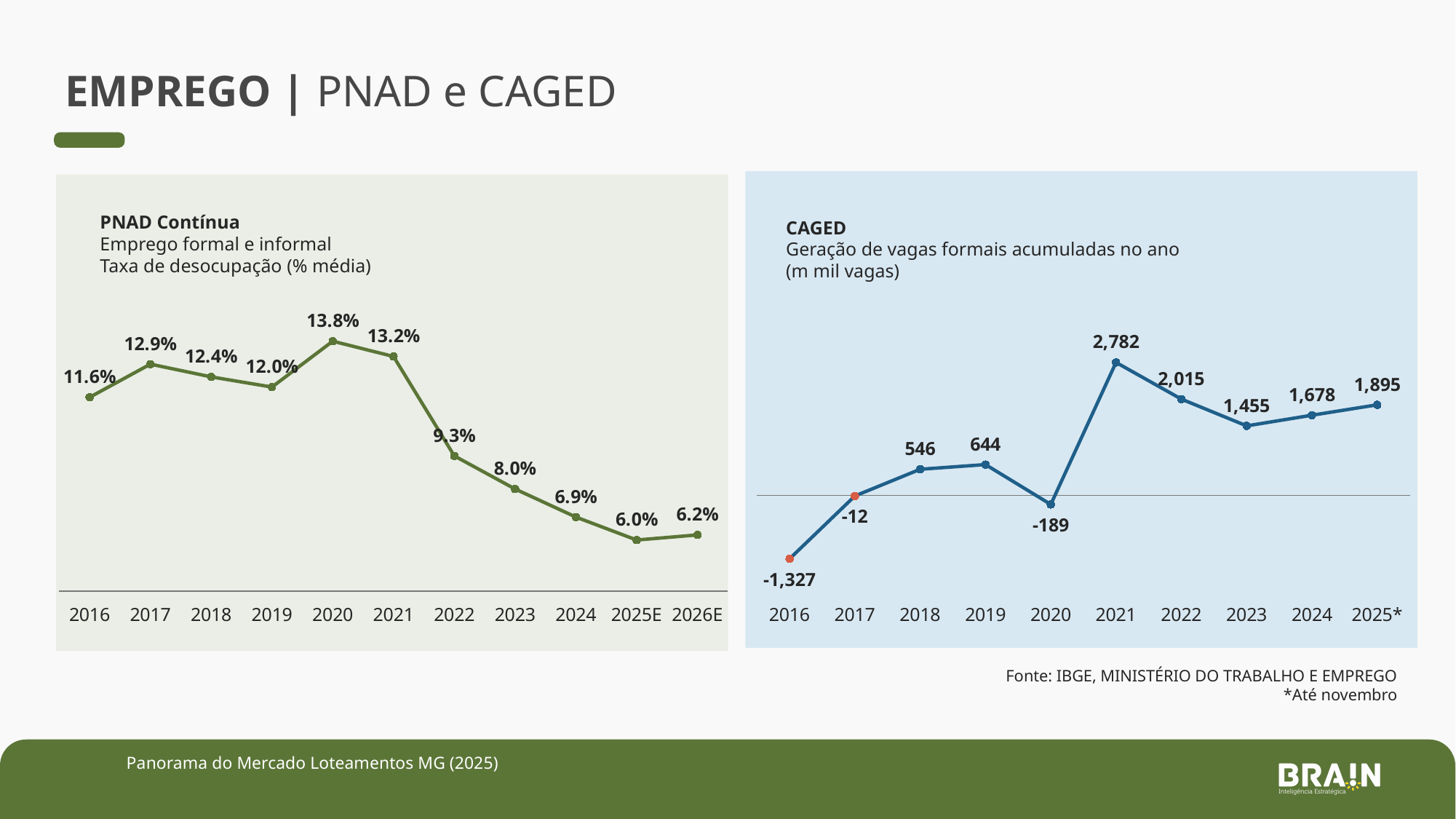
In the CAGED chart, what is the value for 2021? 2,782 What kind of chart is the CAGED chart? line chart In the CAGED chart, which year has the lowest value? 2016 In the PNAD Contínua chart, what is the difference between the 2020 and 2022 values? 4.5 percentage points In the PNAD Contínua chart, what is the unemployment rate for 2020? 13.8% In the CAGED chart, how many years have negative values? 3 In the PNAD Contínua chart, which year has the lowest unemployment rate? 2025E In the PNAD Contínua chart, how many years are plotted on the x axis? 11 In the PNAD Contínua chart, does the unemployment rate rise or fall from 2021 to 2025E? fall In the CAGED chart, which is larger, the value for 2022 or the value for 2025*? 2022 What unit does the CAGED chart subtitle say the values are in? m mil vagas In the CAGED chart, what is the difference between the 2021 and 2022 values? 767